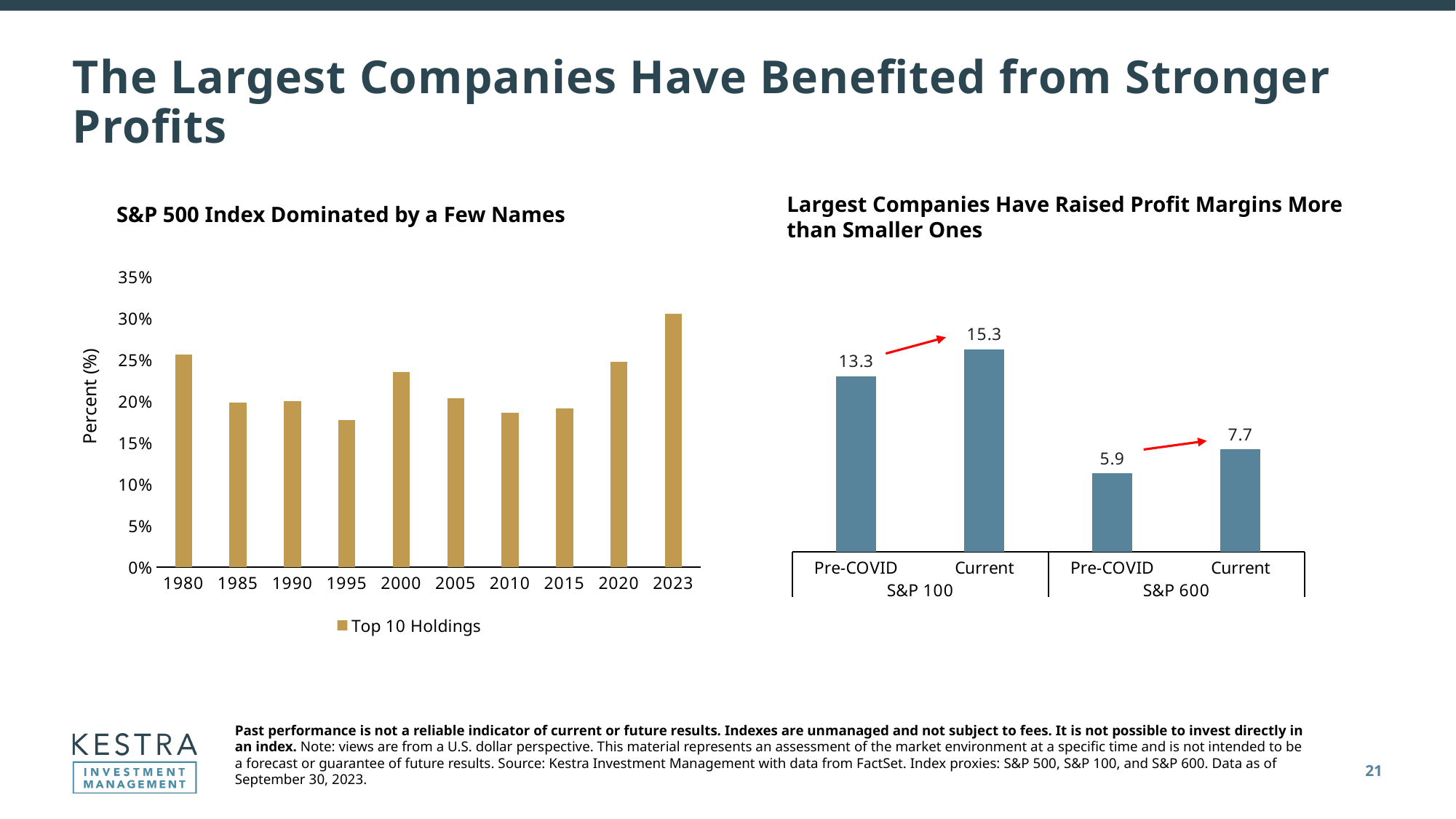
In the chart titled "Largest Companies Have Raised Profit Margins More than Smaller Ones", what is the Current value for the S&P 600? 7.7 In the chart titled "Largest Companies Have Raised Profit Margins More than Smaller Ones", what is the Pre-COVID value for the S&P 600? 5.9 In the chart titled "Largest Companies Have Raised Profit Margins More than Smaller Ones", by how much did the S&P 600 value rise from Pre-COVID to Current? 1.8 In the chart titled "S&P 500 Index Dominated by a Few Names", is the value for 2023 greater or less than 25%? greater In the chart titled "S&P 500 Index Dominated by a Few Names", what series does the legend list? Top 10 Holdings In the chart titled "Largest Companies Have Raised Profit Margins More than Smaller Ones", which bar is the highest? S&P 100 Current In the chart titled "Largest Companies Have Raised Profit Margins More than Smaller Ones", what is the Pre-COVID value for the S&P 100? 13.3 In the chart titled "S&P 500 Index Dominated by a Few Names", is the value for 1995 greater or less than 20%? less In the chart titled "S&P 500 Index Dominated by a Few Names", which year has the highest bar? 2023 In the chart titled "Largest Companies Have Raised Profit Margins More than Smaller Ones", which bar is the lowest? S&P 600 Pre-COVID In the chart titled "Largest Companies Have Raised Profit Margins More than Smaller Ones", by how much did the S&P 100 value rise from Pre-COVID to Current? 2.0 In the chart titled "S&P 500 Index Dominated by a Few Names", how many years are shown on the x axis? 10